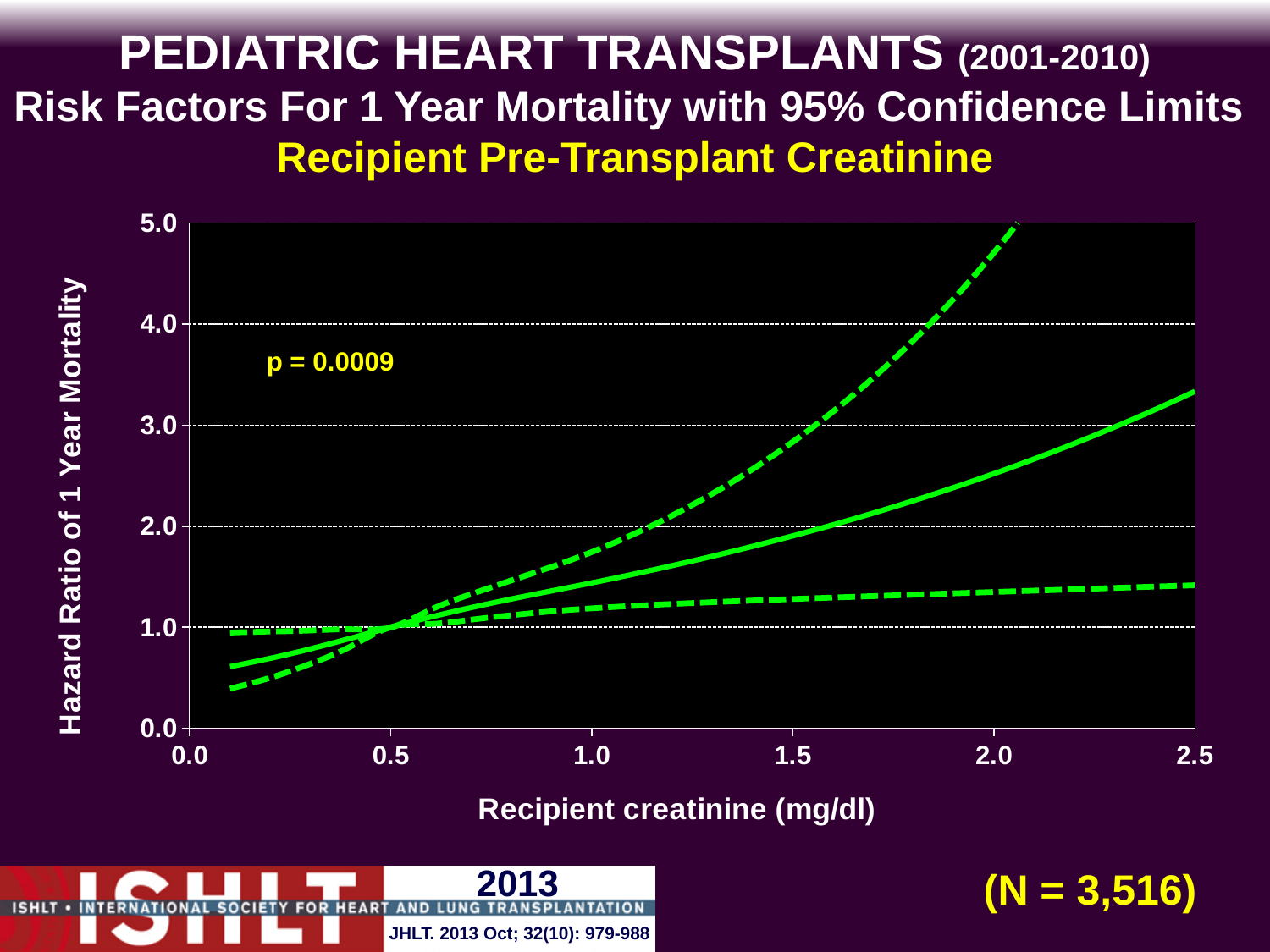
Is the hazard ratio on the solid line at a recipient creatinine of 1.0 mg/dl greater or less than 2.0? less How many lines are plotted on the chart? 3 Is the lower dashed confidence limit at a recipient creatinine of 2.5 mg/dl greater or less than 2.0? less Is the hazard ratio on the solid line at a recipient creatinine of 2.5 mg/dl greater or less than 3.0? greater Does the solid hazard ratio line rise or fall as recipient creatinine increases along the x axis? rise What is the label of the y axis? Hazard Ratio of 1 Year Mortality What kind of chart is shown on the slide? line chart What p-value is printed on the chart? p = 0.0009 At a recipient creatinine of 2.5 mg/dl, which is larger: the upper dashed confidence limit or the lower dashed confidence limit? upper dashed confidence limit